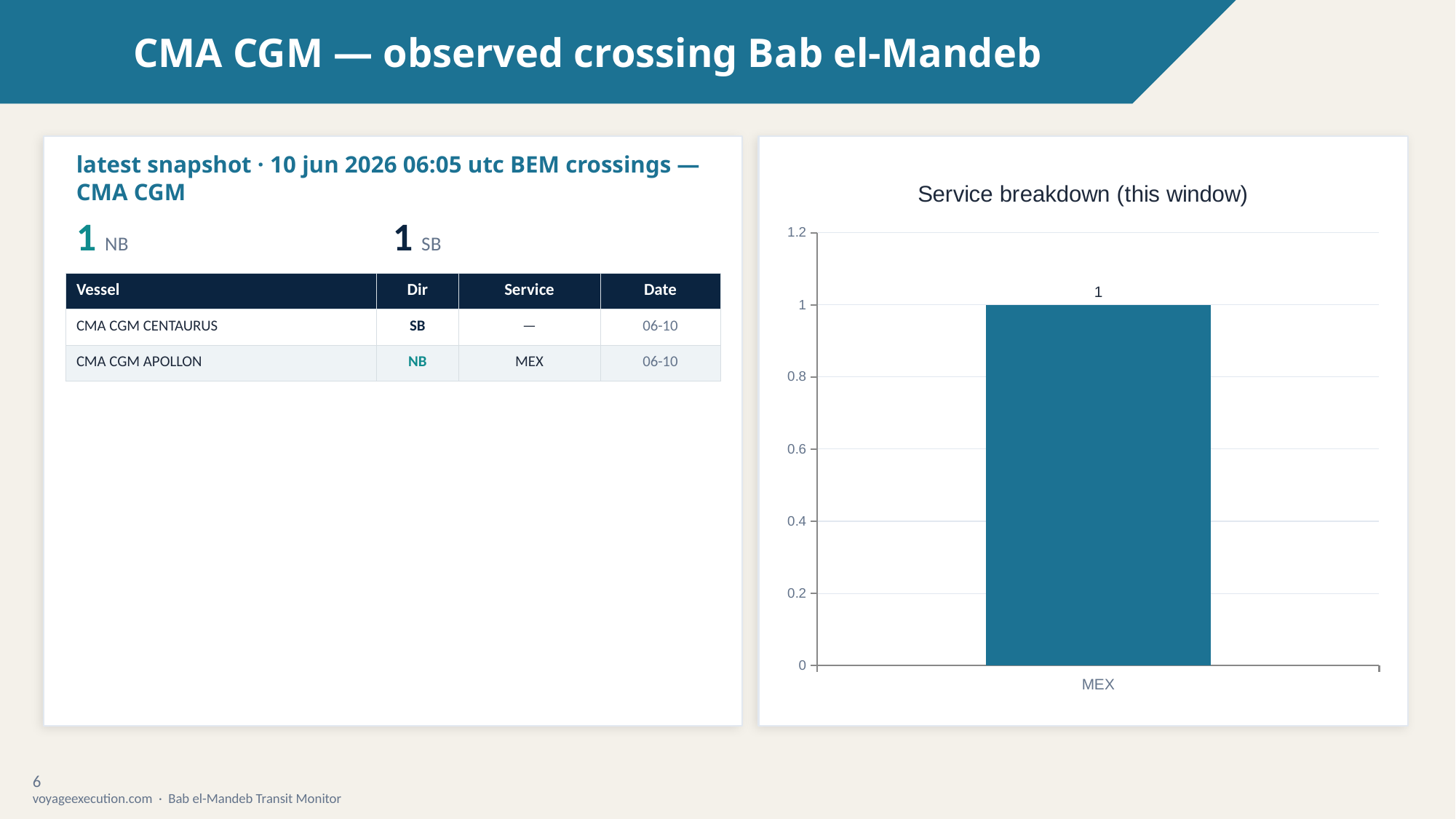
What is the maximum value shown on the y axis of the Service breakdown chart? 1.2 What kind of chart is the Service breakdown chart? bar chart What is the title of the chart on the right of the slide? Service breakdown (this window) Which category has the highest value in the Service breakdown chart? MEX What is the value for MEX in the Service breakdown chart? 1 Is the value for MEX in the Service breakdown chart greater or less than 1.2? less How many categories are shown on the x axis of the Service breakdown chart? 1 Is the value for MEX in the Service breakdown chart greater or less than 0.8? greater